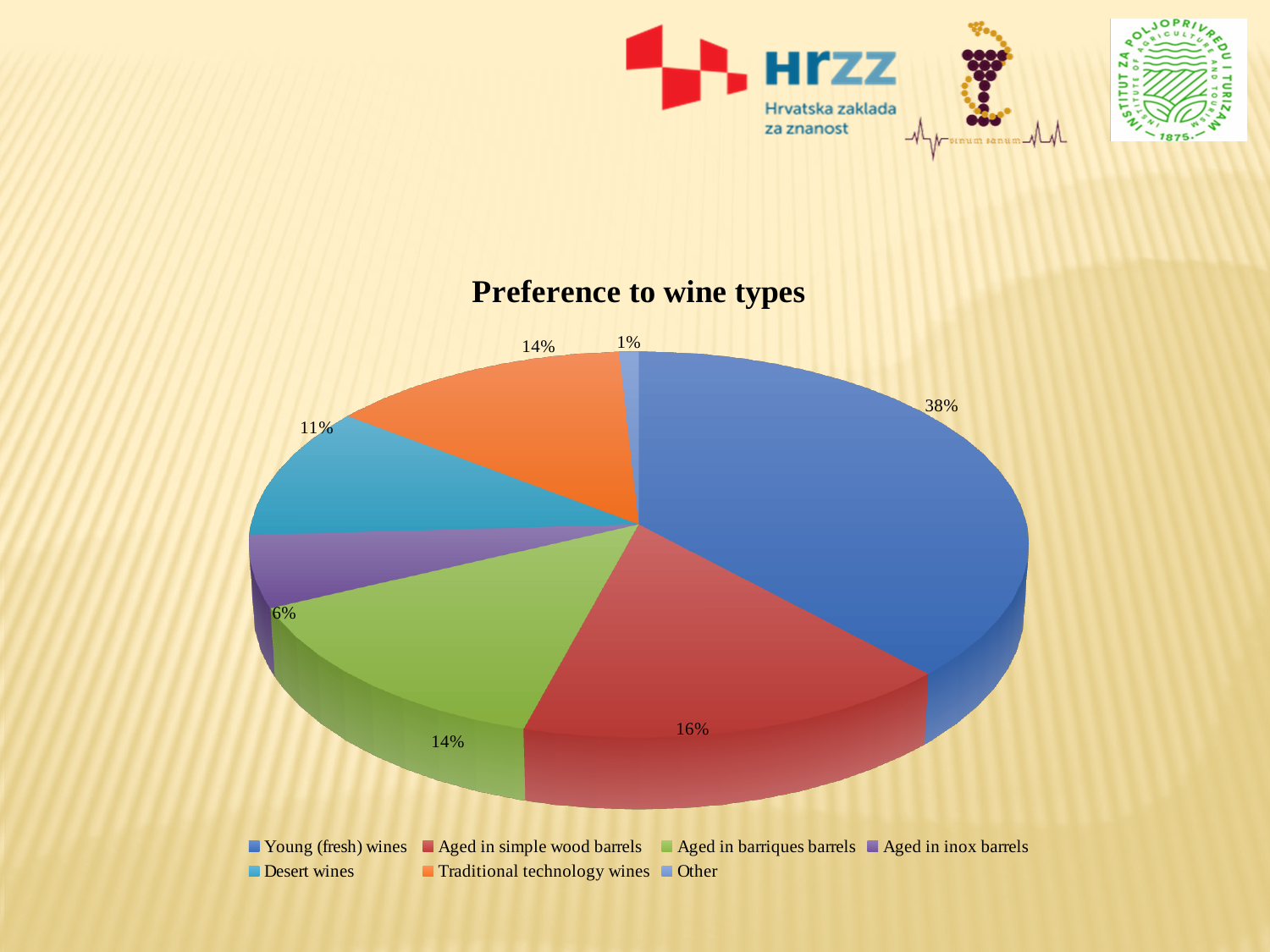
What is the title of the chart? Preference to wine types Which wine type has the smallest share of the pie? Other What share of the pie is Desert wines? 11% What share of the pie is Aged in inox barrels? 6% Which wine type has the largest share of the pie? Young (fresh) wines How many wine types (slices) does the pie chart show? 7 What kind of chart is shown on the slide? Pie chart What share of the pie is Young (fresh) wines? 38% What is the difference in percentage points between Young (fresh) wines and Aged in simple wood barrels? 22 Which has a larger share, Desert wines or Aged in inox barrels? Desert wines